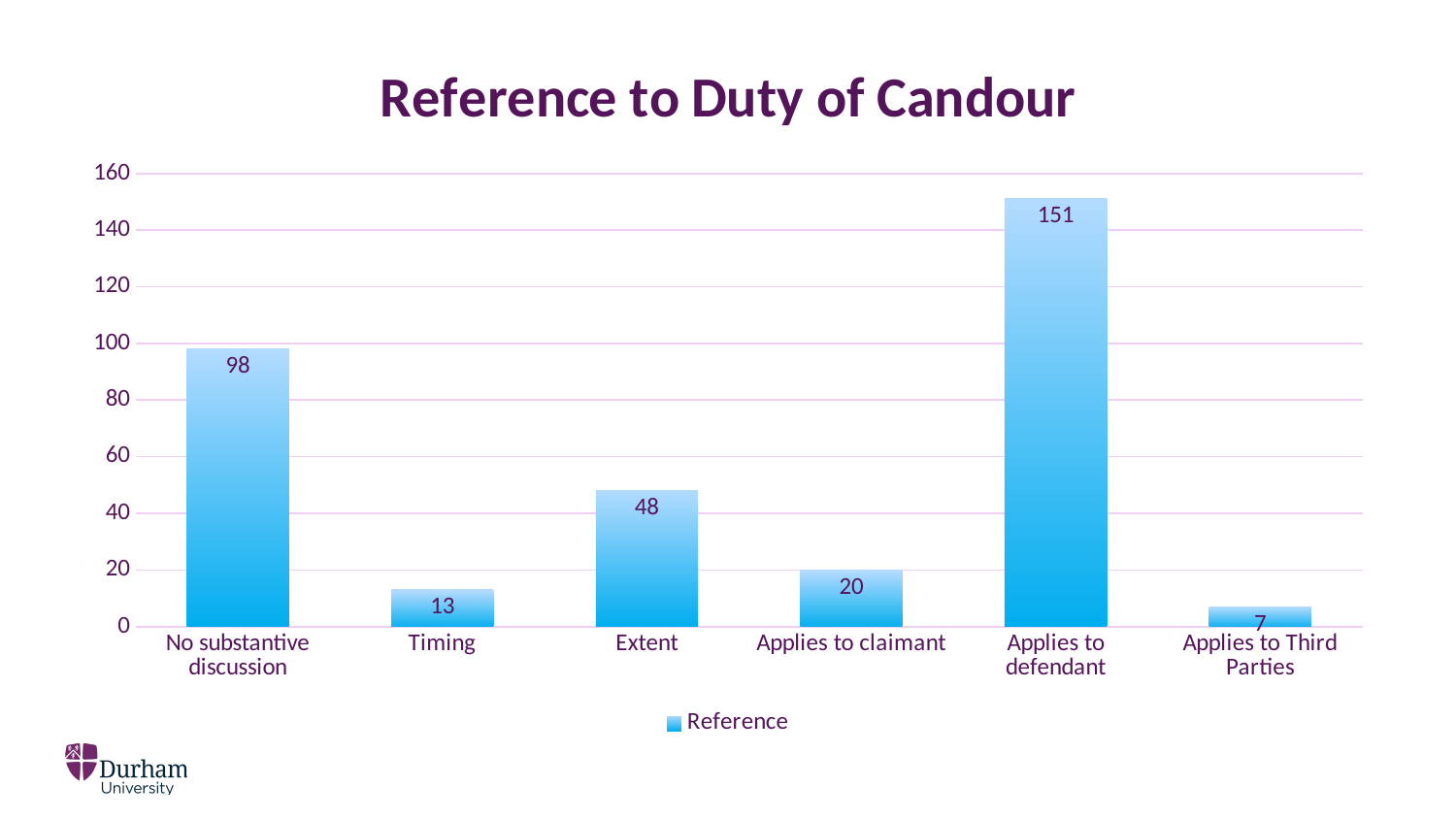
How many categories are shown on the x axis? 6 Is the value for "Applies to defendant" greater or less than 140? greater Which category has the highest value? Applies to defendant What kind of chart is shown on the slide? Bar chart How many series does the legend list? 1 What is the value for "Timing"? 13 What is the title of the chart? Reference to Duty of Candour Which is larger, the value for "Extent" or the value for "Applies to claimant"? Extent What is the value for "Applies to defendant"? 151 What is the value for "No substantive discussion"? 98 What is the difference between the values for "Applies to defendant" and "No substantive discussion"? 53 Which category has the lowest value? Applies to Third Parties